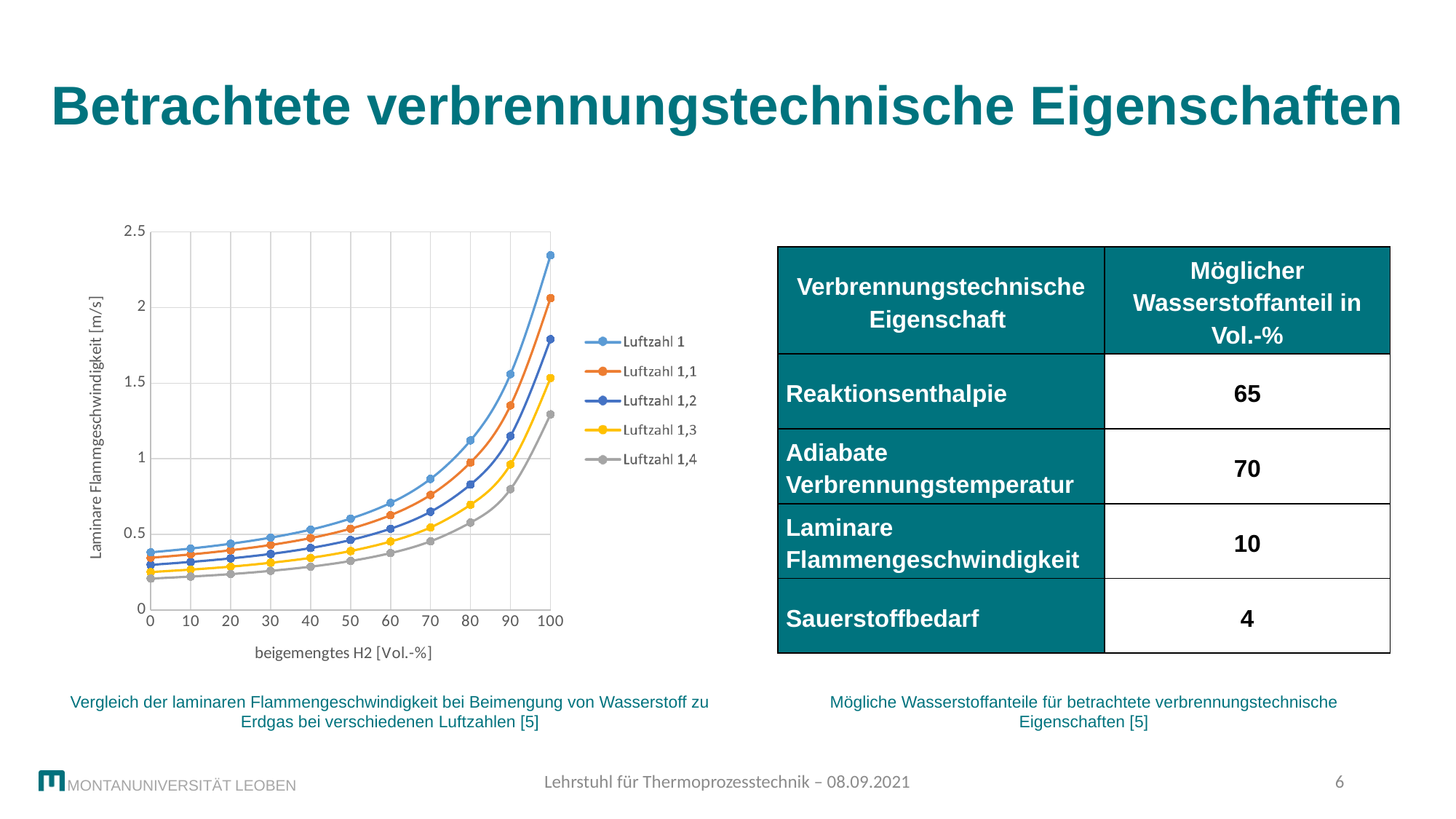
Is the value for Luftzahl 1 at 0 Vol.-% H2 greater or less than 0.5? less Do the laminar flame speed values rise or fall as the H2 share increases along the x axis? rise How many series does the chart legend list? 5 How many data points are plotted for each series along the x axis? 11 Is the value for Luftzahl 1,4 at 90 Vol.-% H2 greater or less than 1? less What kind of chart is shown on the slide? line chart What is the label of the y axis of the chart? Laminare Flammgeschwindigkeit [m/s] Is the value for Luftzahl 1,2 at 100 Vol.-% H2 greater or less than 2? less Which series has the lowest laminar flame speed at 100 Vol.-% H2? Luftzahl 1,4 Which series has the highest laminar flame speed at 100 Vol.-% H2? Luftzahl 1